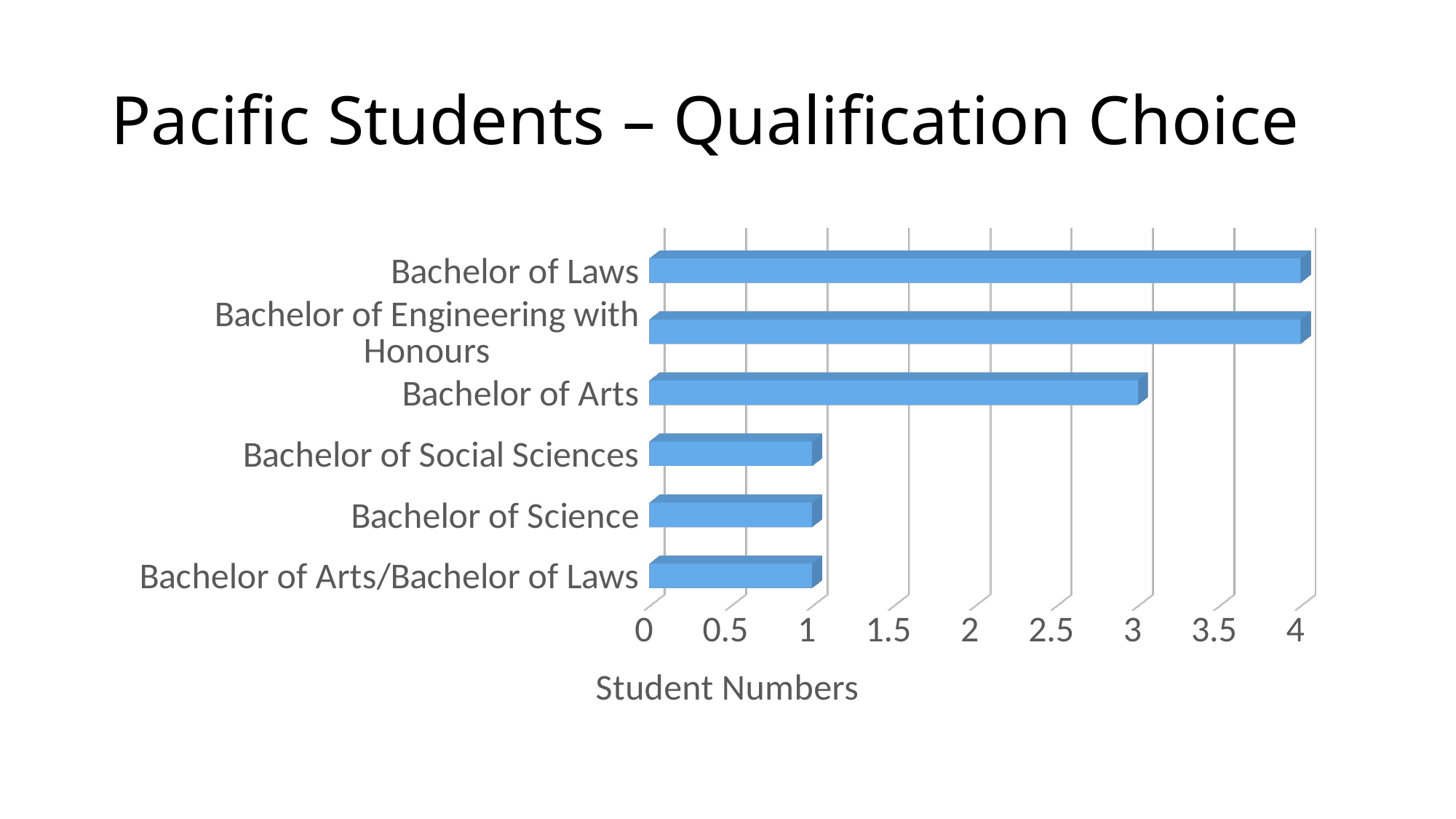
Is the value for Bachelor of Engineering with Honours greater or less than 2? greater How many qualifications are shown in the chart? 6 What kind of chart is shown on the slide? bar chart What is the title of the horizontal axis? Student Numbers Which is larger, the value for Bachelor of Arts or the value for Bachelor of Science? Bachelor of Arts What is the value for Bachelor of Laws? 4 What is the value for Bachelor of Social Sciences? 1 What is the value for Bachelor of Arts/Bachelor of Laws? 1 What is the value for Bachelor of Engineering with Honours? 4 What is the difference between the values for Bachelor of Arts and Bachelor of Social Sciences? 2 What is the difference between the values for Bachelor of Laws and Bachelor of Arts? 1 What is the value for Bachelor of Arts? 3